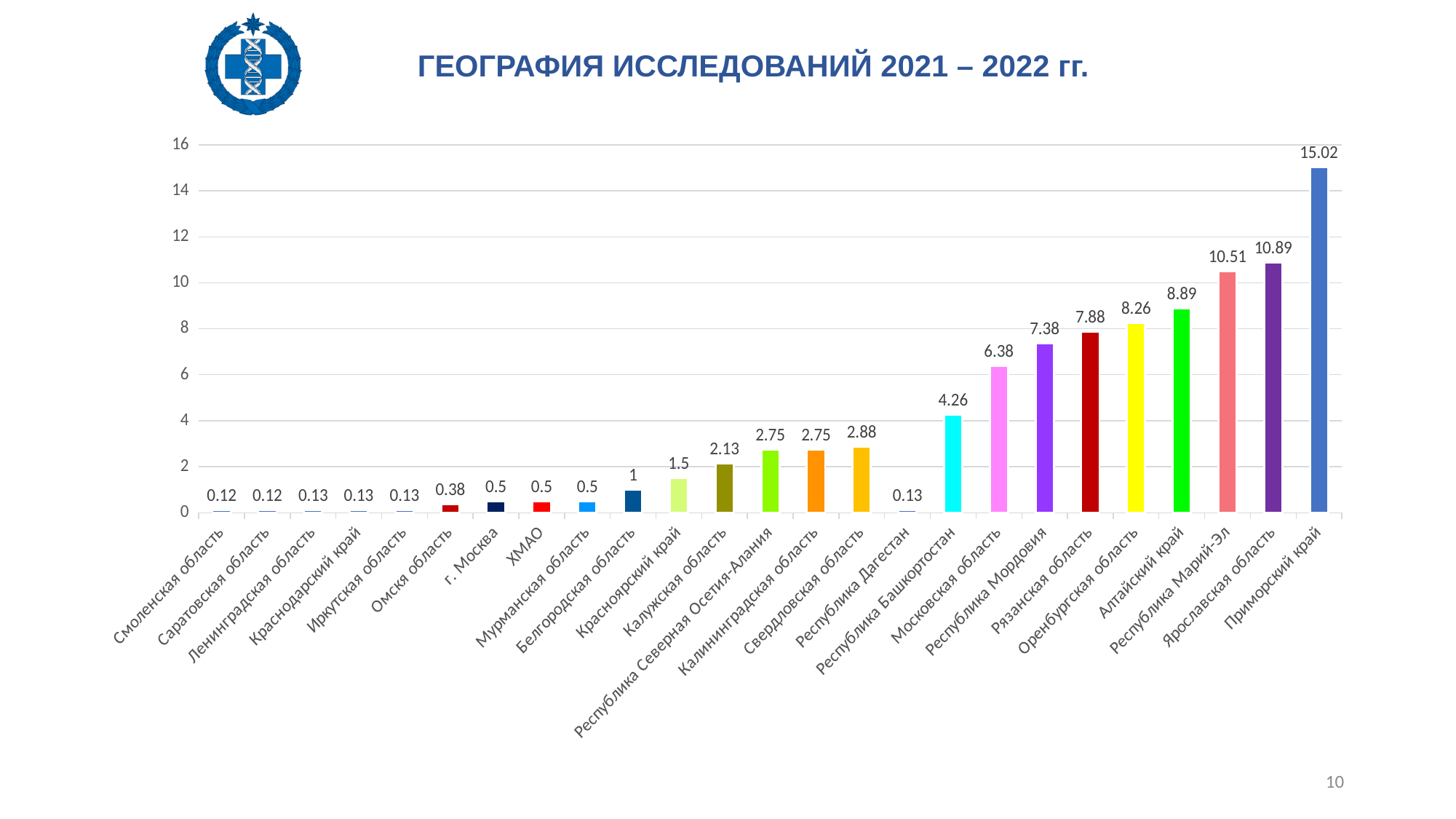
How many regions are shown on the chart? 25 What is the difference between the values for Ярославская область and Республика Марий-Эл? 0.38 Which is larger, the value for Московская область or the value for Республика Мордовия? Республика Мордовия Is the value for Оренбургская область greater or less than 8? greater What kind of chart is shown on the slide? bar chart What is the value for Республика Дагестан? 0.13 What is the value for Республика Башкортостан? 4.26 What is the value for Алтайский край? 8.89 What is the title of the slide? ГЕОГРАФИЯ ИССЛЕДОВАНИЙ 2021 – 2022 гг. Which region has the highest value? Приморский край What is the difference between the values for Приморский край and Ярославская область? 4.13 What is the value for Приморский край? 15.02